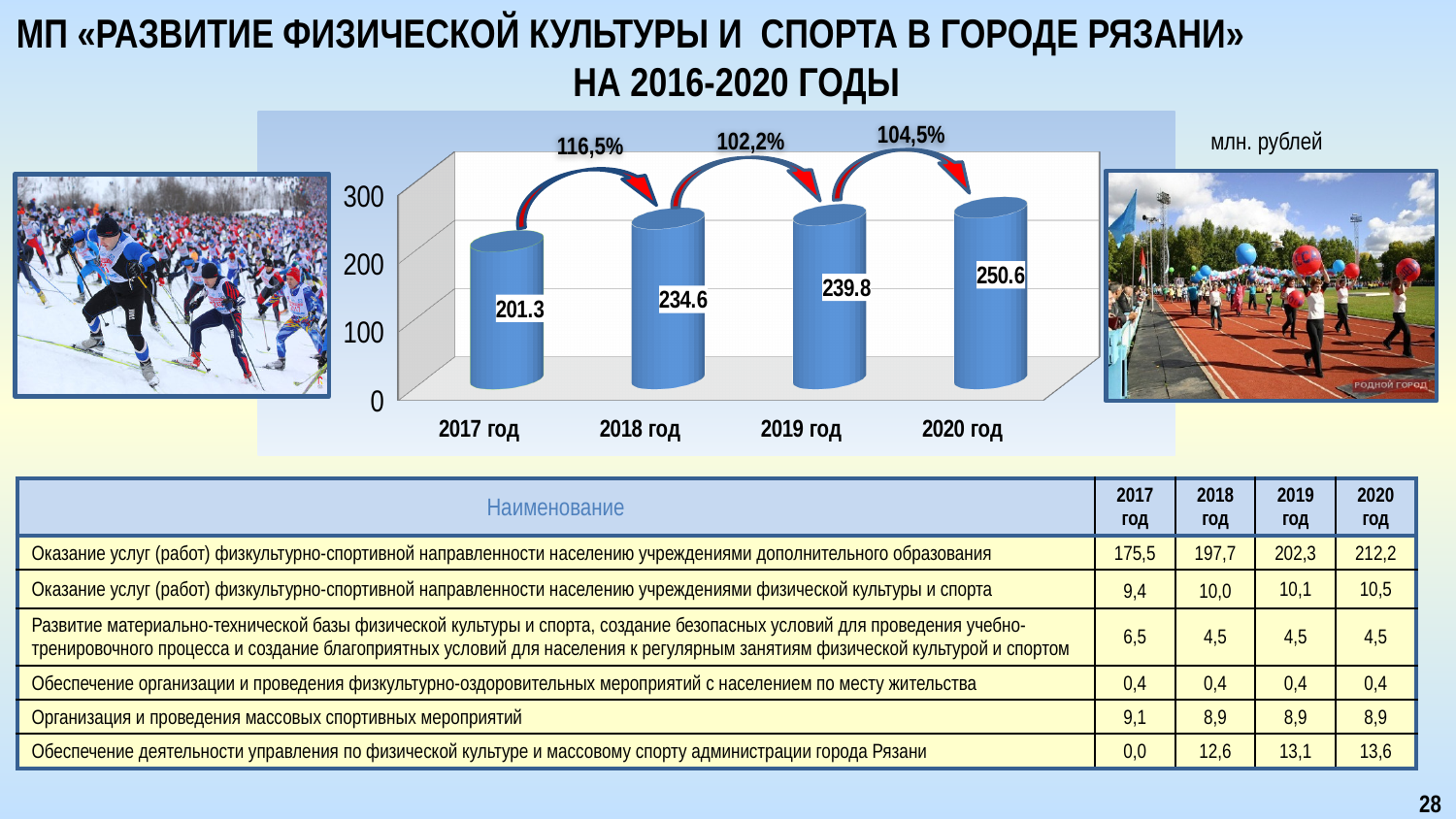
Which year has the lowest value? 2017 год Which is larger, the value for 2018 год or the value for 2019 год? 2019 год What kind of chart is shown on the slide? bar chart What is the value for 2020 год? 250.6 What is the difference between the values for 2020 год and 2019 год? 10.8 Do the values rise or fall from 2017 год to 2020 год? rise What is the difference between the values for 2018 год and 2017 год? 33.3 What is the value for 2017 год? 201.3 Is the value for 2017 год greater or less than 200? greater How many years are shown on the chart? 4 Which year has the highest value? 2020 год What is the value for 2019 год? 239.8